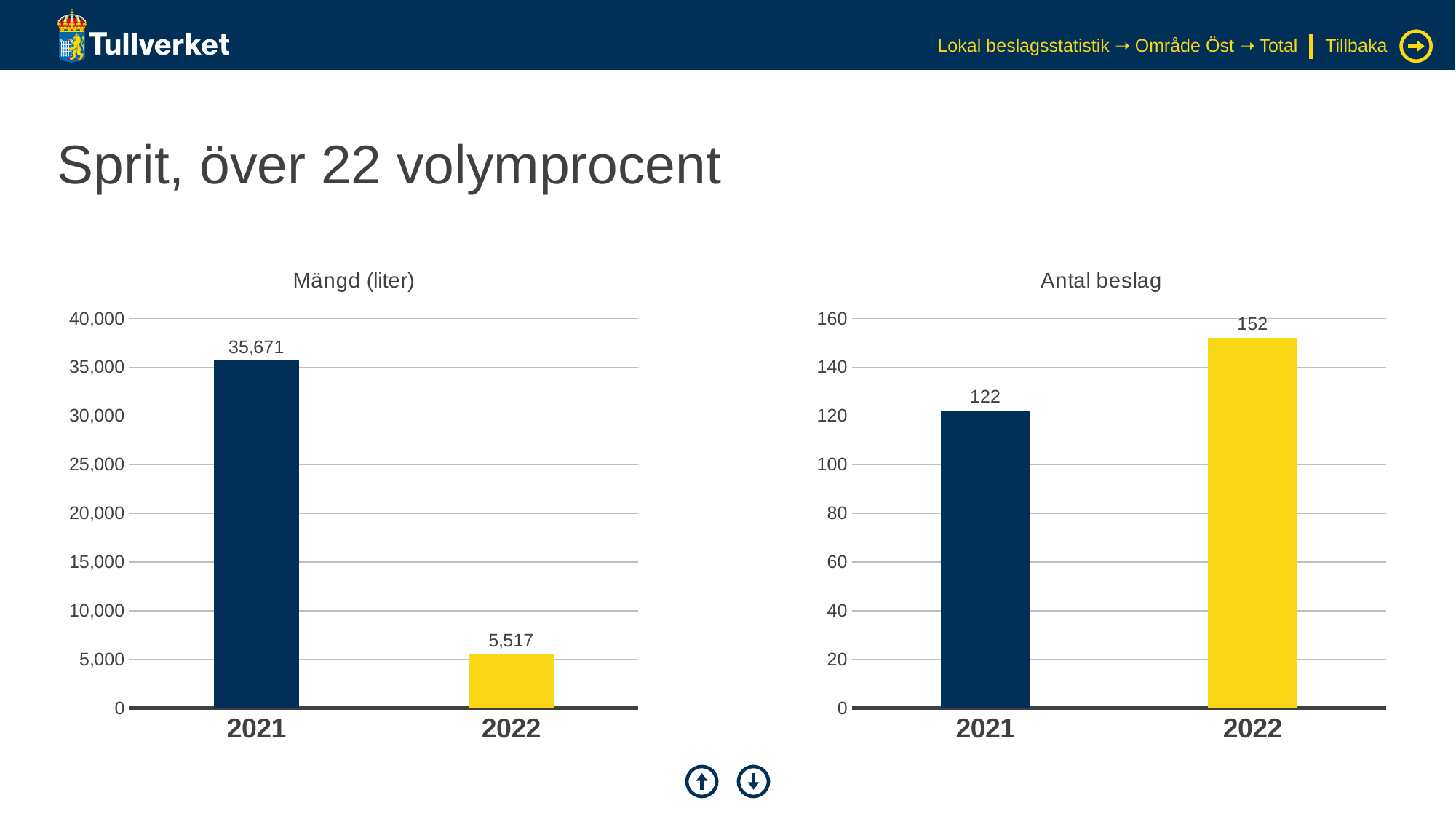
In the 'Antal beslag' chart, what is the difference between the 2022 and 2021 values? 30 How many years are shown in the 'Mängd (liter)' chart? 2 In the 'Mängd (liter)' chart, what is the difference between the 2021 and 2022 values? 30,154 In the 'Antal beslag' chart, which year has the lowest value? 2021 In the 'Antal beslag' chart, which is larger, the value for 2021 or 2022? 2022 In the 'Mängd (liter)' chart, what is the value for 2021? 35,671 In the 'Antal beslag' chart, what is the value for 2021? 122 In the 'Antal beslag' chart, what is the value for 2022? 152 In the 'Mängd (liter)' chart, what is the value for 2022? 5,517 In the 'Mängd (liter)' chart, do the values rise or fall from 2021 to 2022? fall What kind of chart is the 'Antal beslag' chart? bar chart In the 'Mängd (liter)' chart, which year has the highest value? 2021